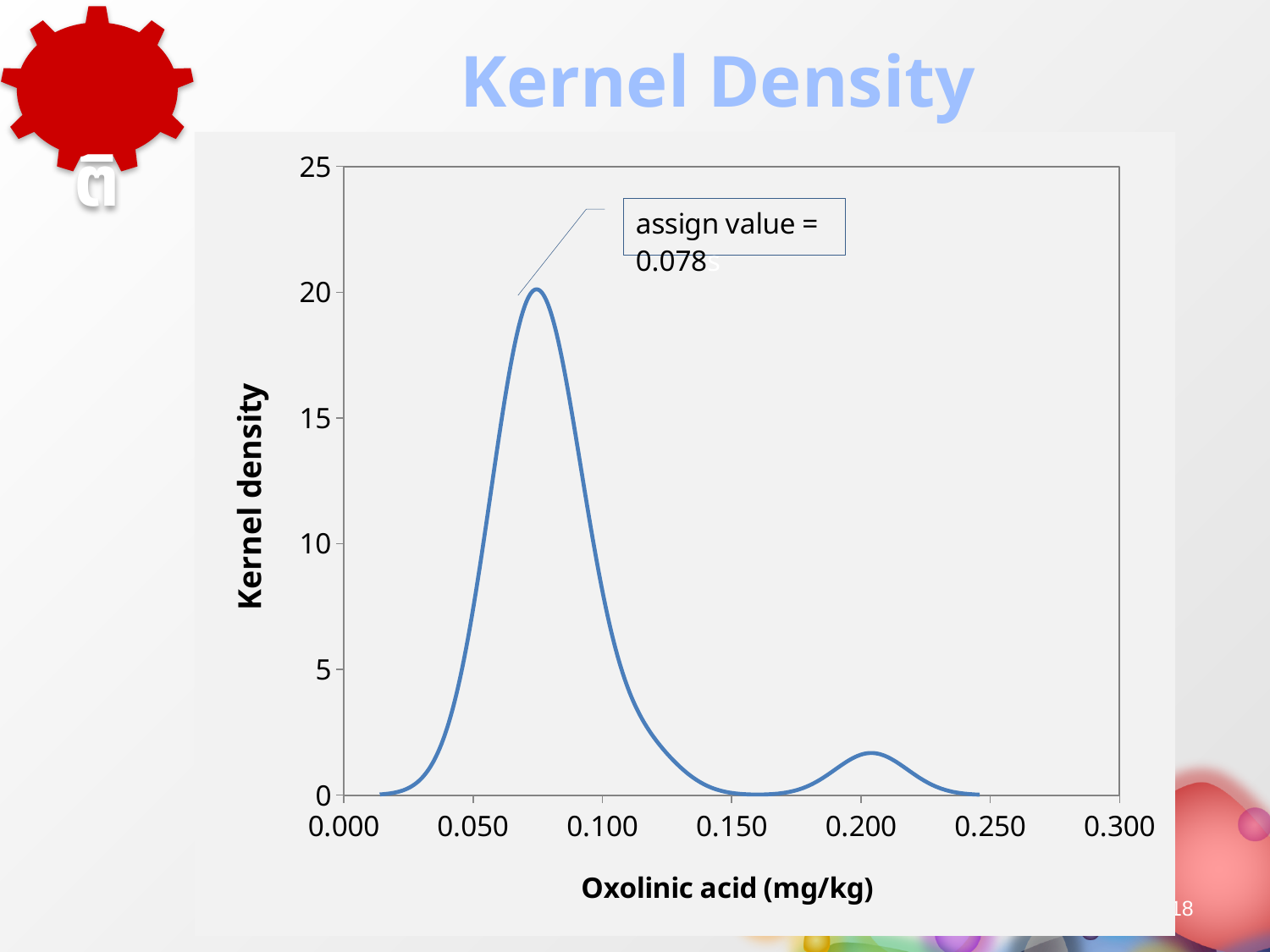
Is the peak kernel density of the curve greater or less than 15? greater Is the kernel density at 0.200 mg/kg greater or less than 5? less What is the label of the x axis? Oxolinic acid (mg/kg) Is the peak kernel density of the curve greater or less than 25? less Which peak is higher: the one near 0.075 mg/kg or the one near 0.200 mg/kg? the one near 0.075 mg/kg What kind of chart is shown on the slide? line chart What is the title of the chart? Kernel Density What assigned value is stated in the annotation on the chart? 0.078 Does the kernel density rise or fall as oxolinic acid increases from 0.100 to 0.150 mg/kg? fall How many peaks does the kernel density curve have? 2 Does the kernel density rise or fall as oxolinic acid increases from 0.050 to 0.075 mg/kg? rise